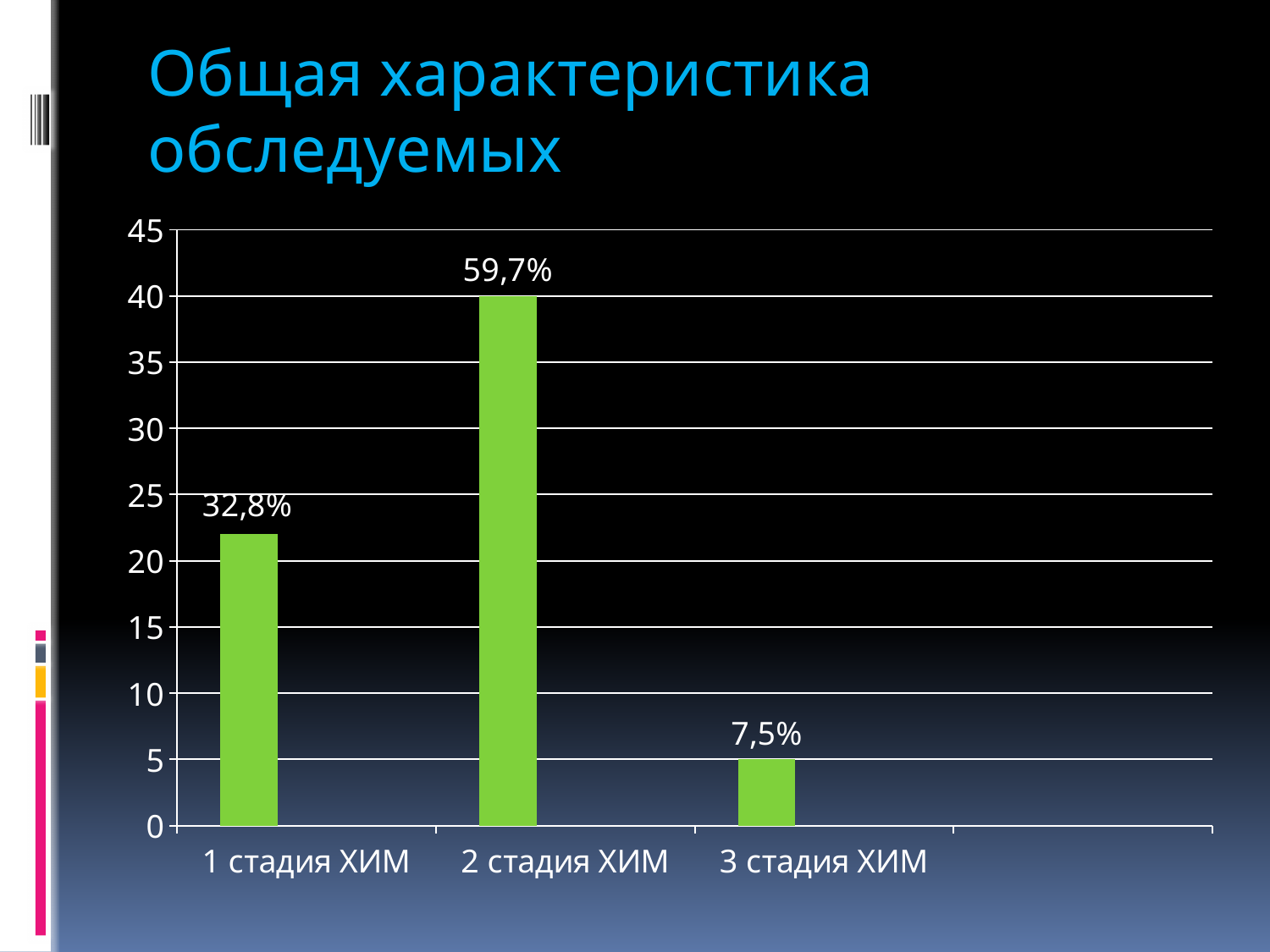
Which category has the highest value? 2 стадия ХИМ Is the bar for 3 стадия ХИМ greater or less than 10 on the vertical axis? less Is the bar for 1 стадия ХИМ greater or less than 25 on the vertical axis? less What is the data label shown for 3 стадия ХИМ? 7,5% What is the difference between the labelled values for 2 стадия ХИМ and 1 стадия ХИМ? 26,9% How many categories are shown on the x axis? 3 What kind of chart is shown on the slide? bar chart Which is larger, the value for 1 стадия ХИМ or 3 стадия ХИМ? 1 стадия ХИМ What is the difference between the labelled values for 1 стадия ХИМ and 3 стадия ХИМ? 25,3% What is the data label shown for 2 стадия ХИМ? 59,7% Which category has the lowest value? 3 стадия ХИМ What is the data label shown for 1 стадия ХИМ? 32,8%